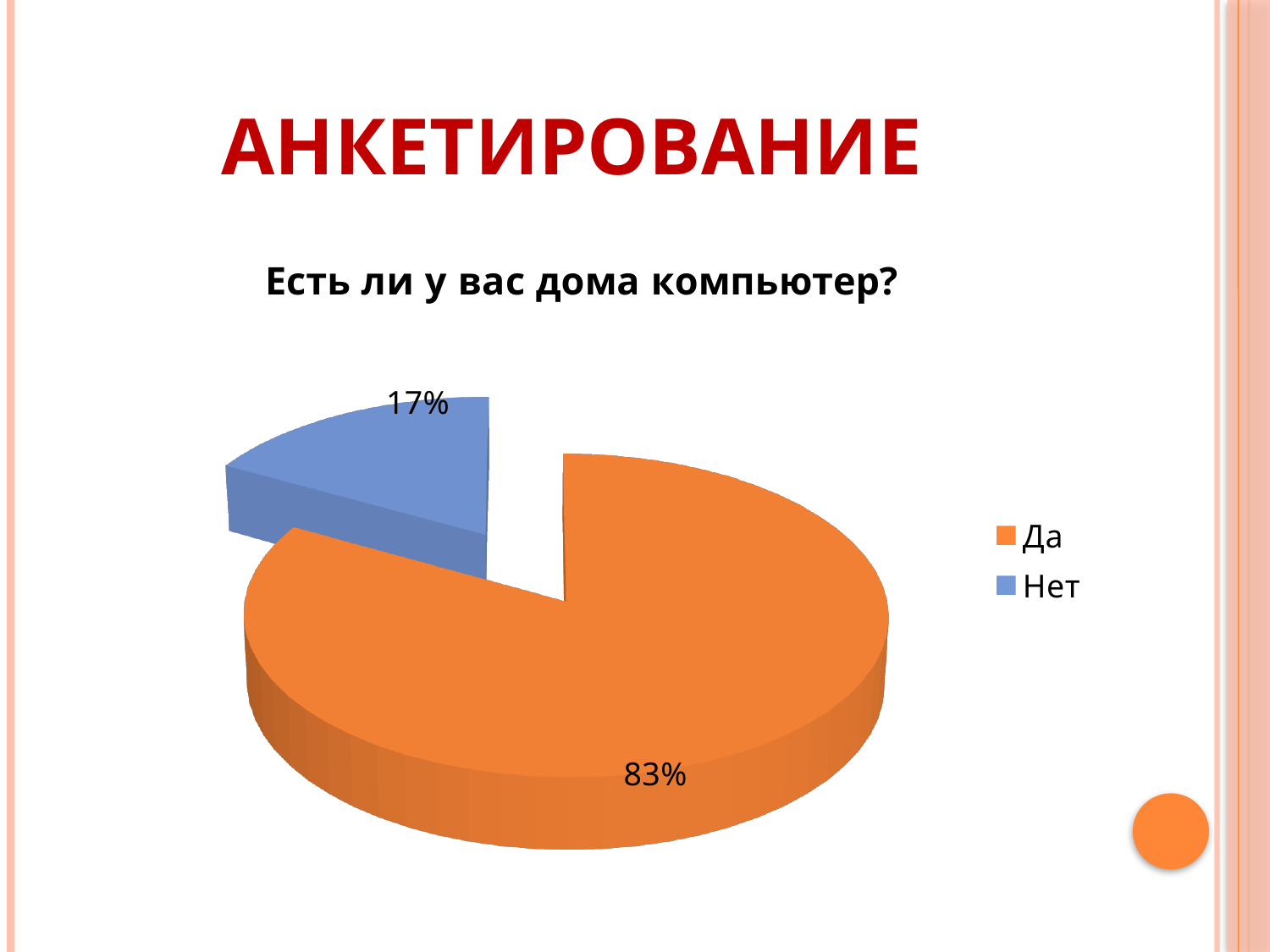
How many entries does the legend list? 2 Which category has the largest slice? Да Which category has the smallest slice? Нет What colour is the "Да" slice? orange What share of the pie does the "Нет" slice represent? 17% Which is larger, the value for "Да" or the value for "Нет"? Да What is the value for "Нет"? 17% How many slices does the pie chart have? 2 What is the difference between the values for "Да" and "Нет"? 66% What is the title of the chart? Есть ли у вас дома компьютер? What is the value for "Да"? 83% What kind of chart is shown on the slide? pie chart